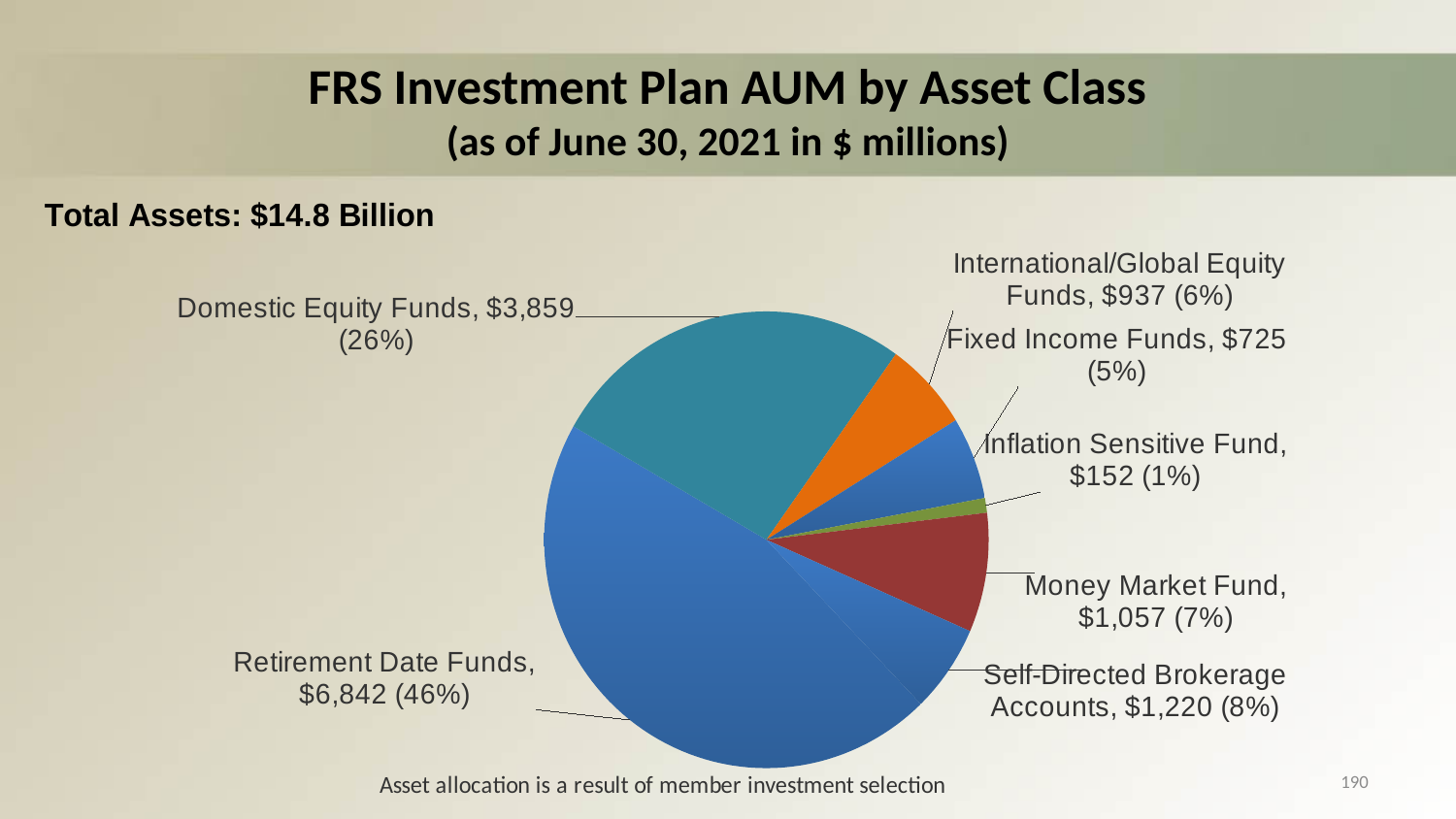
How many asset classes are shown in the pie chart? 7 What share of the pie do International/Global Equity Funds represent? 6% What is the value for Money Market Fund? $1,057 What is the title of the chart? FRS Investment Plan AUM by Asset Class What is the value for Domestic Equity Funds? $3,859 What kind of chart is shown on the slide? pie chart Which asset class has the largest share of the pie? Retirement Date Funds Which asset class has the smallest share of the pie? Inflation Sensitive Fund What is the difference between the values for Domestic Equity Funds and Fixed Income Funds? $3,134 What share of the pie do Self-Directed Brokerage Accounts represent? 8% Which is larger, Money Market Fund or Self-Directed Brokerage Accounts? Self-Directed Brokerage Accounts What is the value for Retirement Date Funds? $6,842